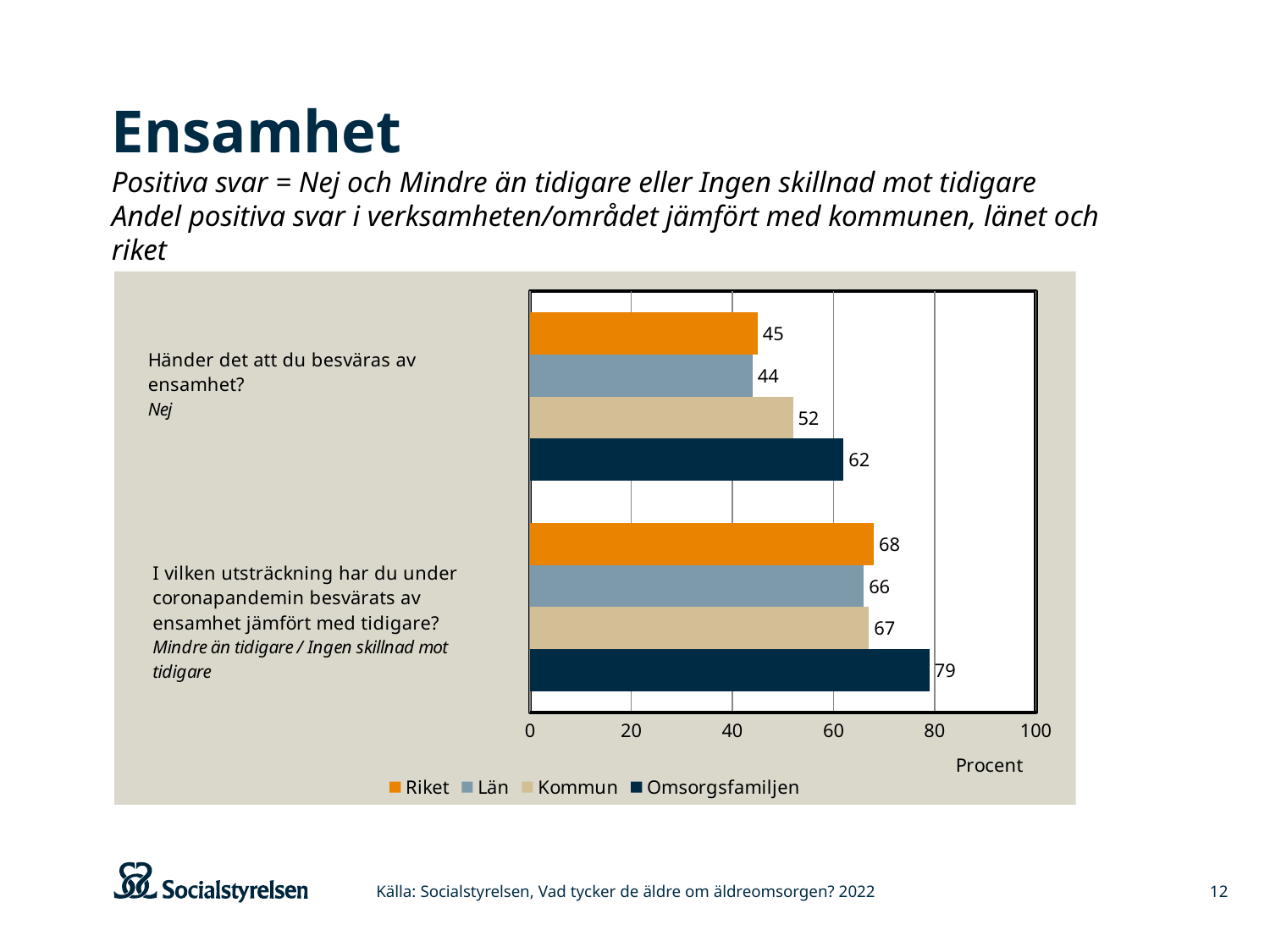
Which is larger for the question "Händer det att du besväras av ensamhet?": the value for Kommun or the value for Riket? Kommun What type of chart is shown on the slide? bar chart Which series has the highest value for the question "I vilken utsträckning har du under coronapandemin besvärats av ensamhet jämfört med tidigare?"? Omsorgsfamiljen What is the value for Riket for the question "I vilken utsträckning har du under coronapandemin besvärats av ensamhet jämfört med tidigare?"? 68 What is the value for Län for the question "Händer det att du besväras av ensamhet?"? 44 What is the difference between the Omsorgsfamiljen and Riket values for the question "I vilken utsträckning har du under coronapandemin besvärats av ensamhet jämfört med tidigare?"? 11 What label is shown on the horizontal axis of the chart? Procent How many question categories are shown on the chart? 2 What is the difference between the Omsorgsfamiljen and Kommun values for the question "Händer det att du besväras av ensamhet?"? 10 What is the value for Omsorgsfamiljen for the question "Händer det att du besväras av ensamhet?"? 62 Which series has the lowest value for the question "Händer det att du besväras av ensamhet?"? Län How many series does the legend list? 4